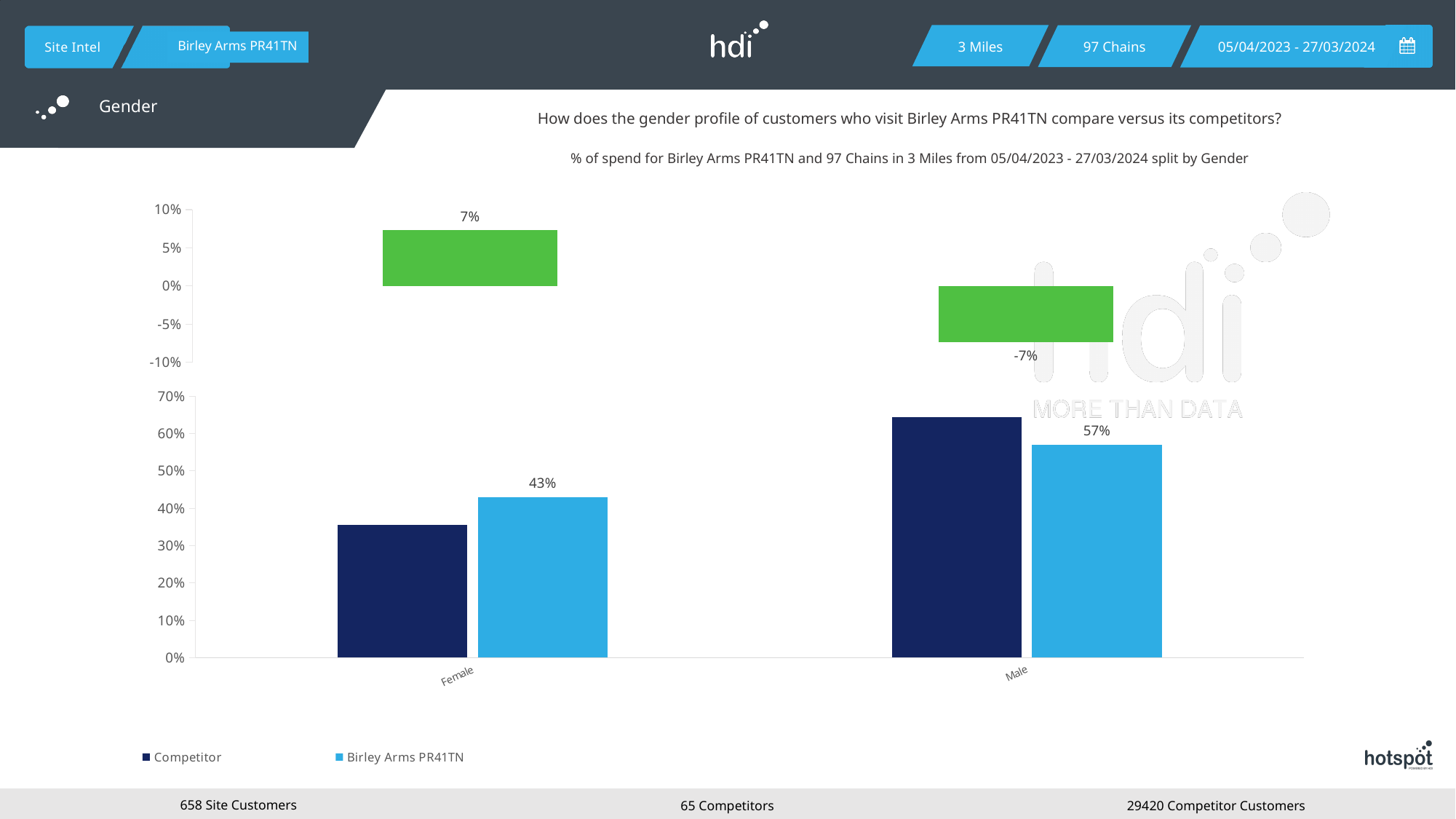
How many series does the legend of the bottom chart list? 2 In the bottom chart, is the Competitor value for Male greater or less than 60%? greater In the bottom chart, which gender has the higher value for Birley Arms PR41TN? Male In the bottom chart, for Male, which is larger: the Competitor value or the Birley Arms PR41TN value? Competitor In the bottom chart, what is the value for Birley Arms PR41TN for Female? 43% What type of chart is the bottom chart? Bar chart In the bottom chart, is the Competitor value for Female greater or less than 40%? less In the bottom chart, for Female, which is larger: the Competitor value or the Birley Arms PR41TN value? Birley Arms PR41TN In the bottom chart, what is the value for Birley Arms PR41TN for Male? 57% In the top chart, what is the value shown for Female? 7% In the top chart, what is the value shown for Male? -7% In the bottom chart, what is the difference between the Birley Arms PR41TN values for Male and Female? 14%